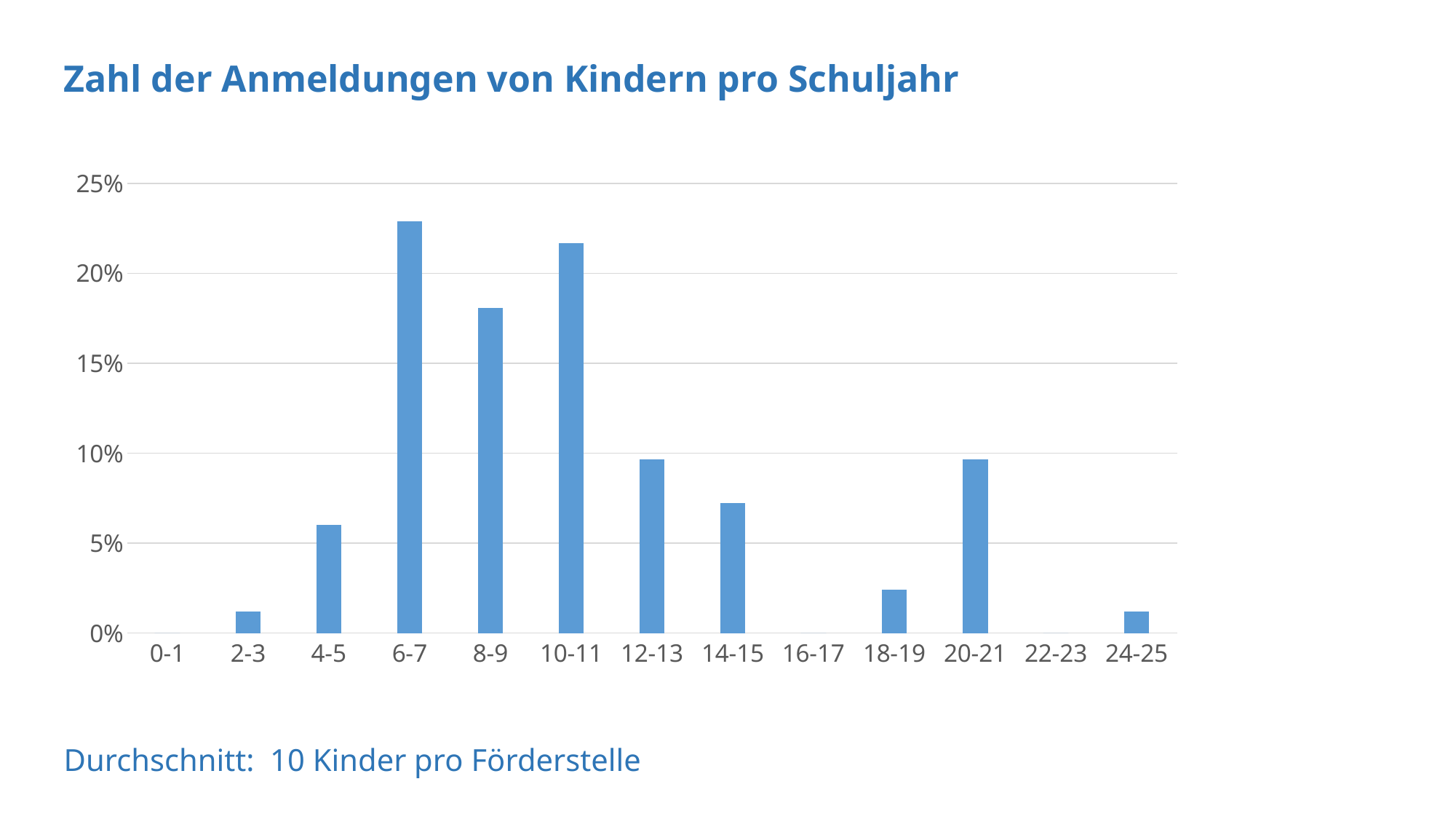
Which is larger, the value for 6-7 or the value for 12-13? 6-7 Is the value for 8-9 greater or less than 20%? less Is the value for 4-5 greater or less than 5%? greater What kind of chart is shown on the slide? bar chart What average is stated in the text below the chart? 10 Kinder pro Förderstelle What is the title of the chart? Zahl der Anmeldungen von Kindern pro Schuljahr Which is larger, the value for 8-9 or the value for 10-11? 10-11 Is the value for 18-19 greater or less than 5%? less How many categories are shown on the x axis? 13 Which category has the highest value? 6-7